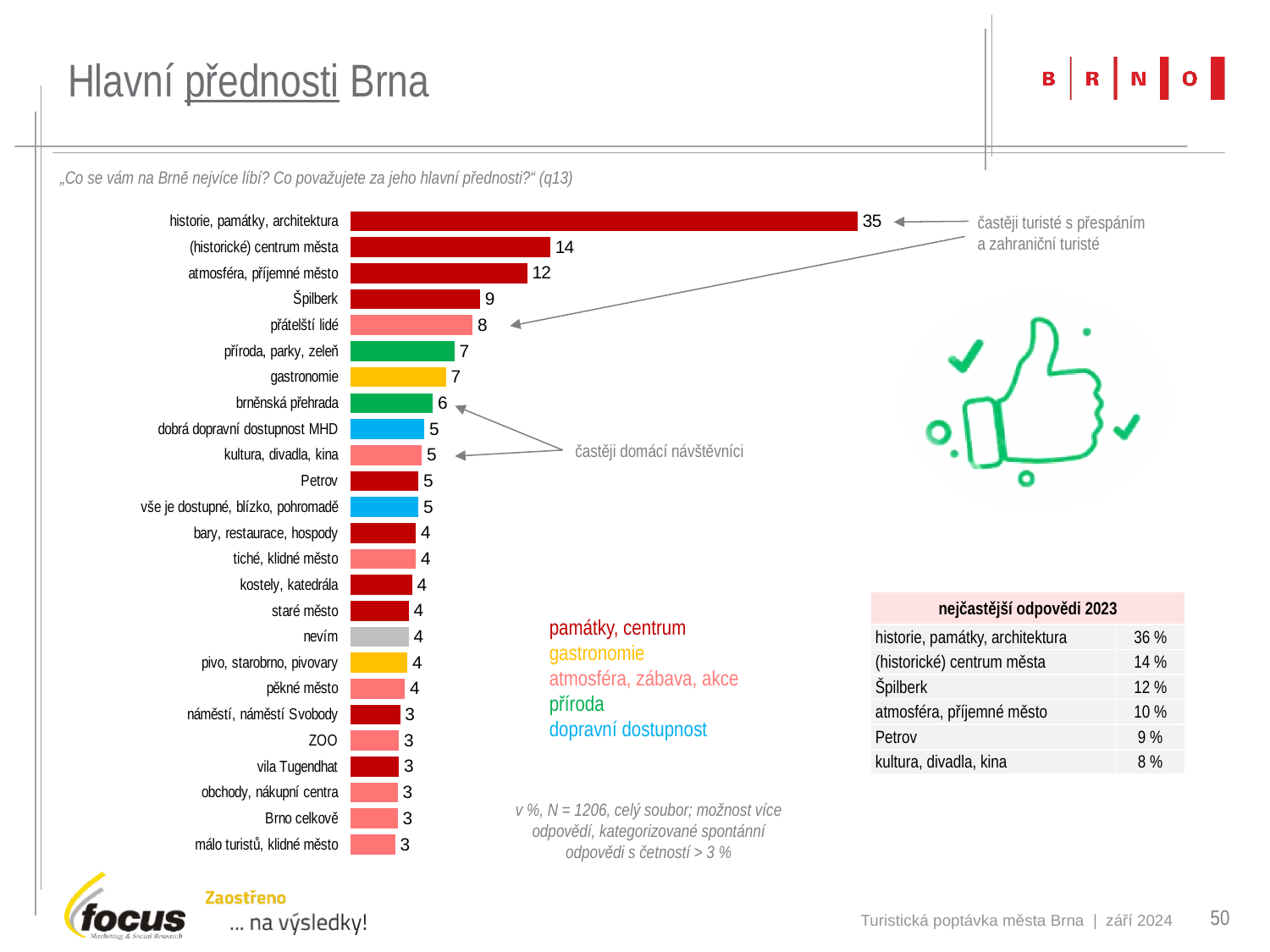
Which is larger, the value for "Petrov" or the value for "ZOO"? Petrov According to the colour key, which colour represents "příroda"? green What value is shown for "Špilberk"? 9 What type of chart is shown on the slide? bar chart How many categories are plotted in the bar chart? 25 Which is larger, the value for "Špilberk" or the value for "gastronomie"? Špilberk Which category has the highest value in the chart? historie, památky, architektura What is the difference between the values for "historie, památky, architektura" and "(historické) centrum města"? 21 What value is shown for "brněnská přehrada"? 6 What value is shown for "vila Tugendhat"? 3 What is the difference between the values for "atmosféra, příjemné město" and "přátelští lidé"? 4 What value is shown for "historie, památky, architektura"? 35